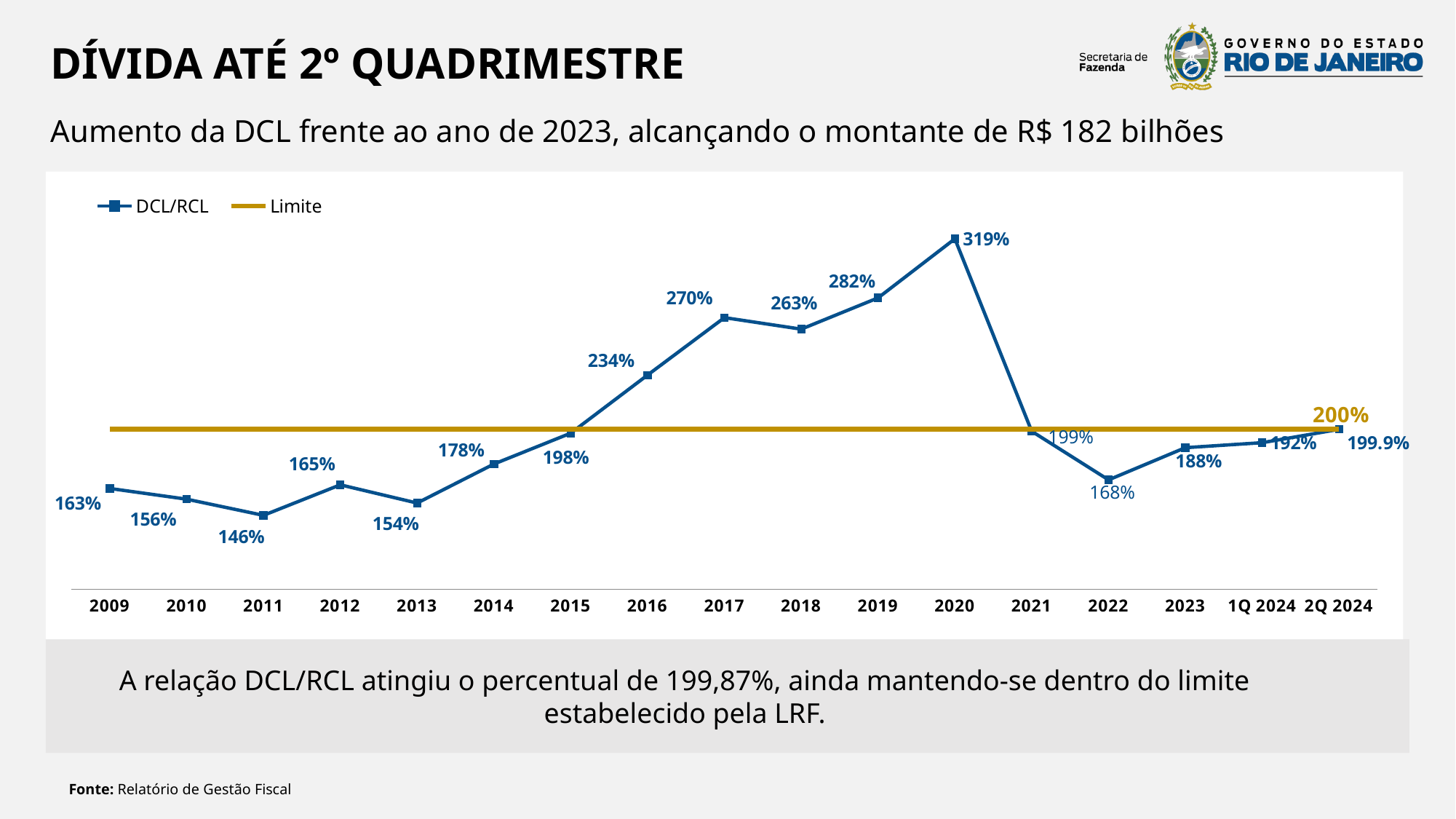
Which year has the lowest DCL/RCL value? 2011 What kind of chart is shown on the slide? Line chart How many series does the legend list? 2 Does the DCL/RCL value rise or fall from 2013 to 2020? Rise What is the DCL/RCL value for 2020? 319% How many points are plotted on the x axis of the chart? 17 What is the difference between the DCL/RCL values for 2020 and 2021? 120% Which year has the highest DCL/RCL value? 2020 Which is larger, the DCL/RCL value for 2017 or for 2018? 2017 What value is shown for the Limite line? 200% What is the DCL/RCL value for 2011? 146% What is the DCL/RCL value for 2Q 2024? 199.9%